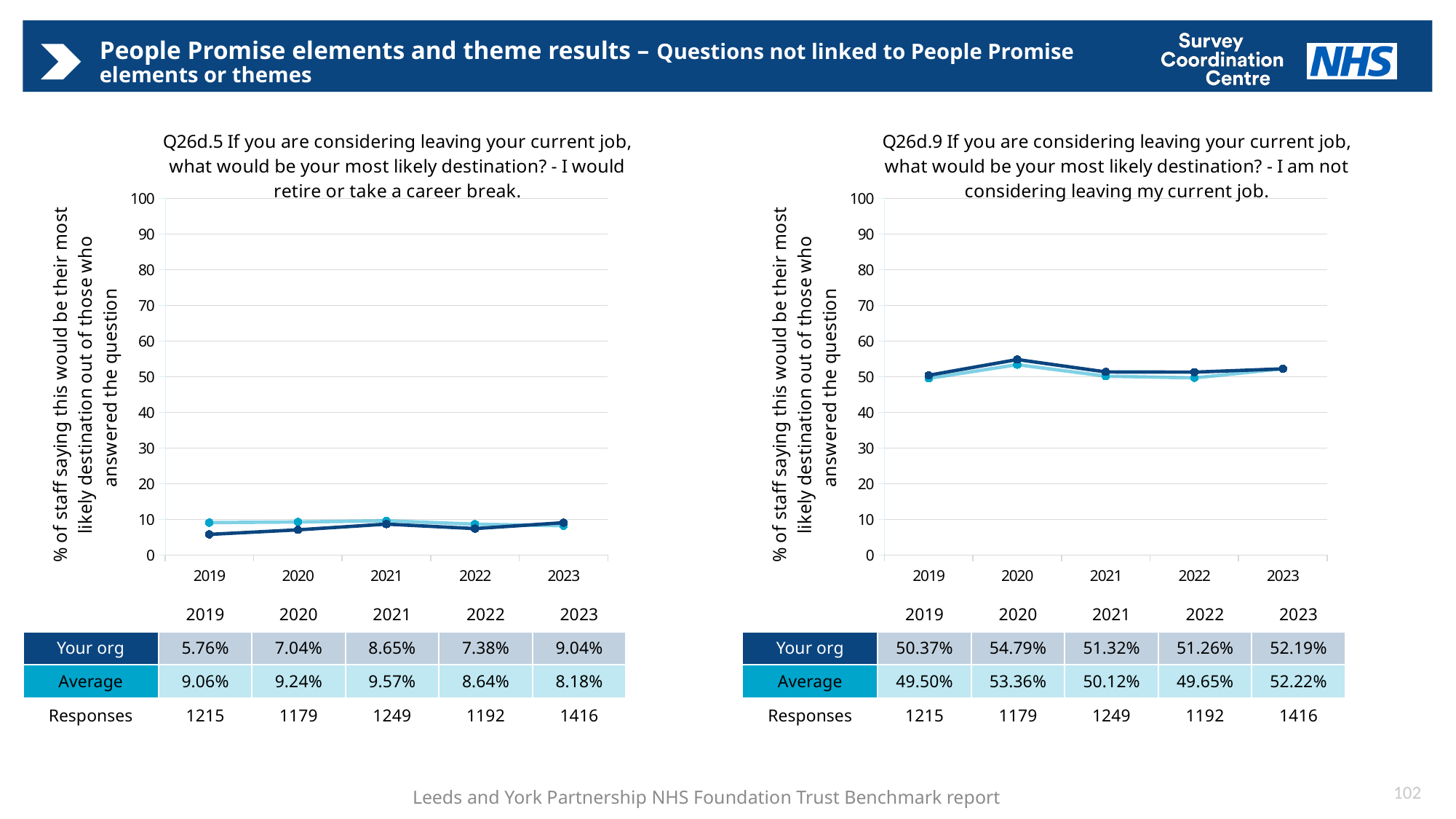
In the Q26d.5 chart (left), what is the Average value for 2022? 8.64% In the Q26d.9 chart (right), by how many percentage points did the Your org value change from 2019 to 2020? 4.42 percentage points In the Q26d.5 chart (left), which is larger in 2019: Your org or Average? Average In the Q26d.9 chart (right), in which year is the Your org value highest? 2020 In the Q26d.9 chart (right), is the Your org value for 2020 greater or less than 50? greater What type of chart is the Q26d.9 chart (right)? Line chart In the Q26d.5 chart (left), what is the Your org value for 2023? 9.04% How many series are plotted in the Q26d.9 chart (right)? 2 In the Q26d.9 chart (right), what is the Average value for 2020? 53.36% In the Q26d.5 chart (left), what is the difference between the Average and Your org values in 2021? 0.92 percentage points How many years are plotted on the x axis of the Q26d.5 chart (left)? 5 In the Q26d.5 chart (left), in which year is the Your org value lowest? 2019